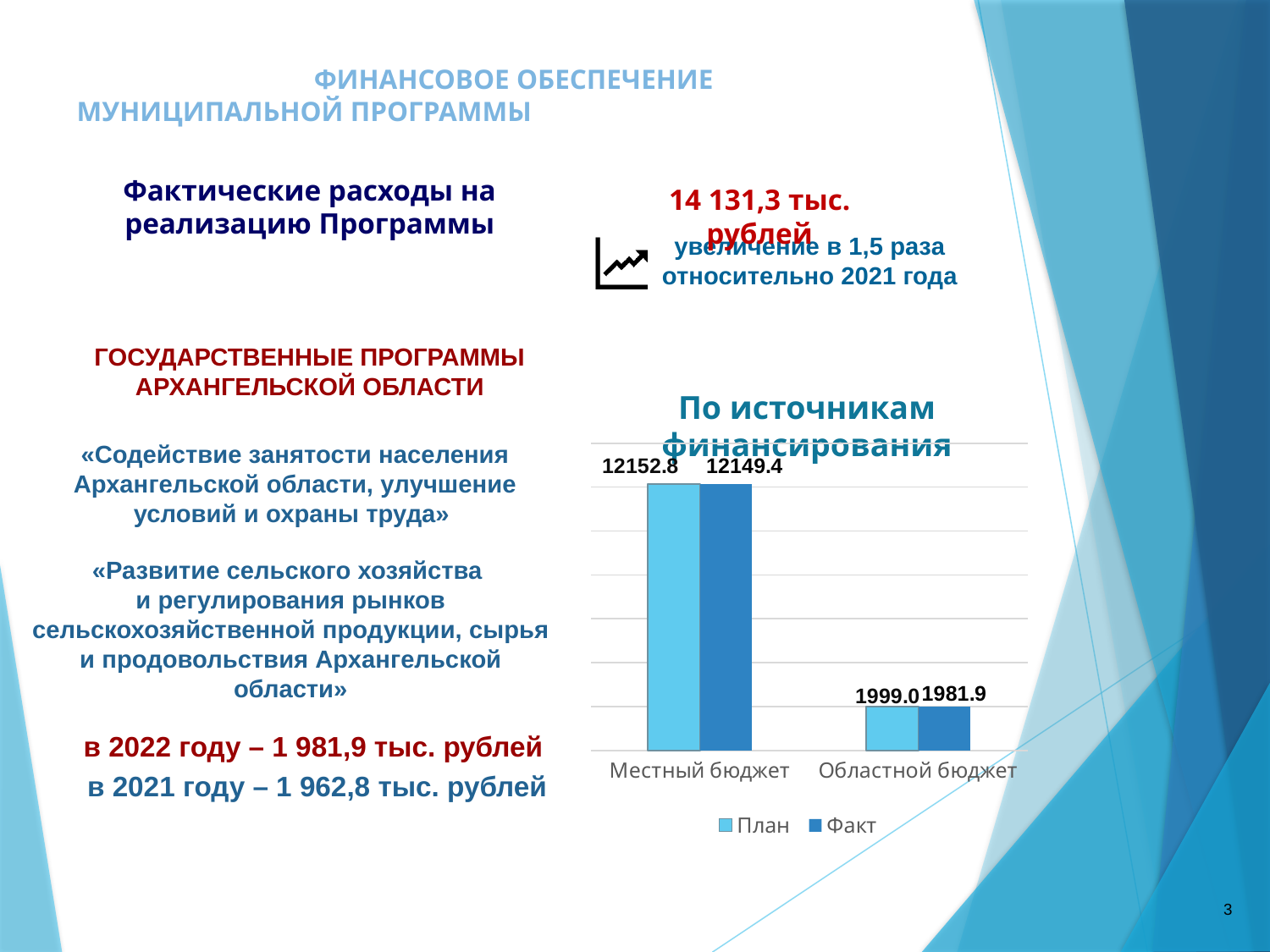
What is the difference between the План and Факт values for Местный бюджет? 3.4 How many series does the chart legend list? 2 What is the План value for Местный бюджет in the chart 'По источникам финансирования'? 12152.8 What is the difference between the План and Факт values for Областной бюджет? 17.1 Which is larger: the Факт value for Местный бюджет or the Факт value for Областной бюджет? Местный бюджет How many categories are shown on the x axis of the chart? 2 What is the Факт value for Областной бюджет in the chart? 1981.9 Which category has the lowest Факт value in the chart? Областной бюджет What is the План value for Областной бюджет in the chart? 1999.0 What type of chart is shown on the slide? Bar chart What is the Факт value for Местный бюджет in the chart? 12149.4 Which category has the highest План value in the chart? Местный бюджет